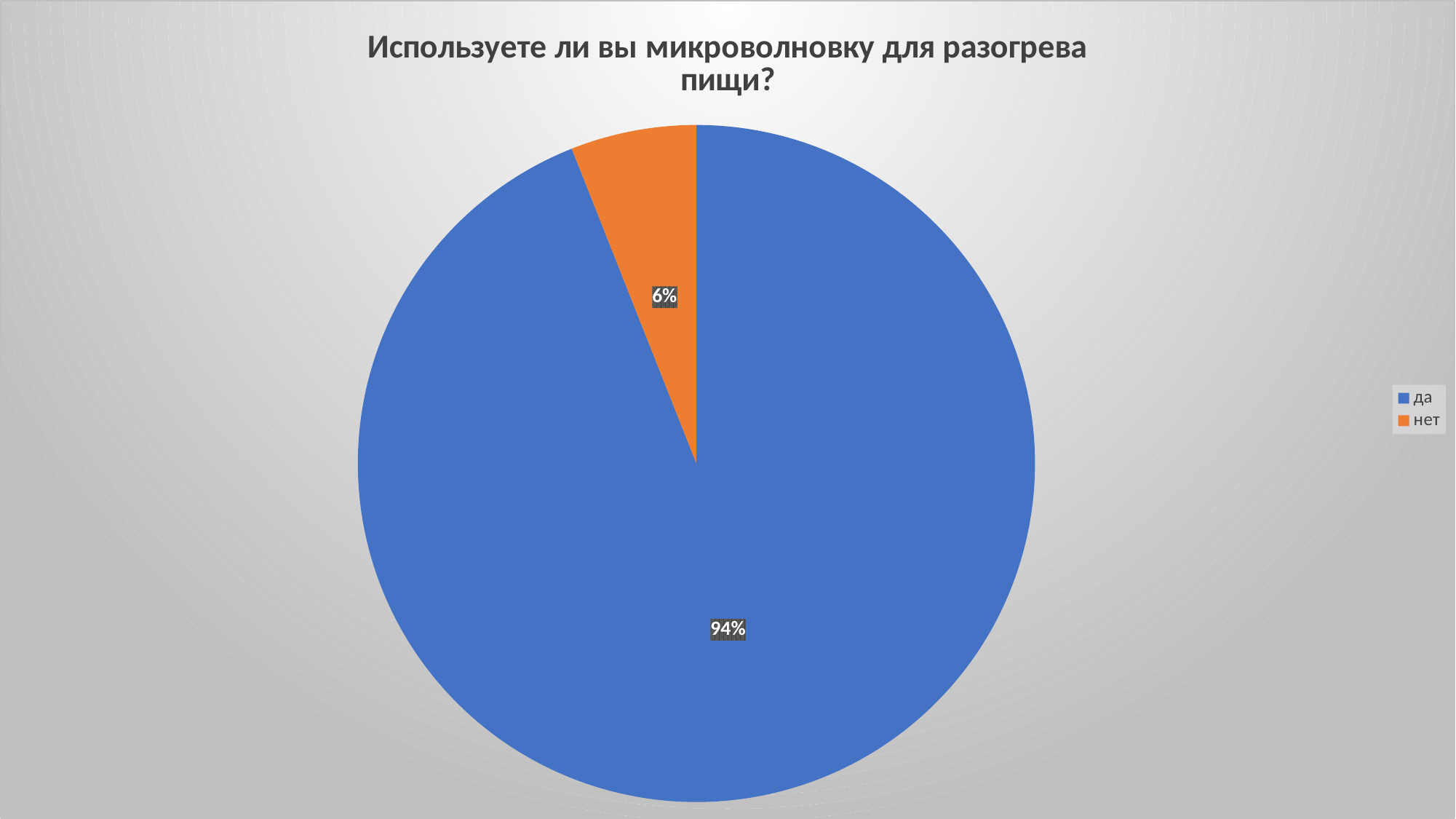
Which is larger, the slice for "да" or the slice for "нет"? да How many entries does the legend list? 2 How many categories does the pie chart have? 2 What is the difference in percentage points between "да" and "нет"? 88 What colour is the slice for "нет"? orange Which category has the smallest slice? нет What share of the pie does "нет" take? 6% Which category has the largest slice? да What share of the pie does "да" take? 94% What kind of chart is shown on the slide? pie chart What is the title of the chart? Используете ли вы микроволновку для разогрева пищи?